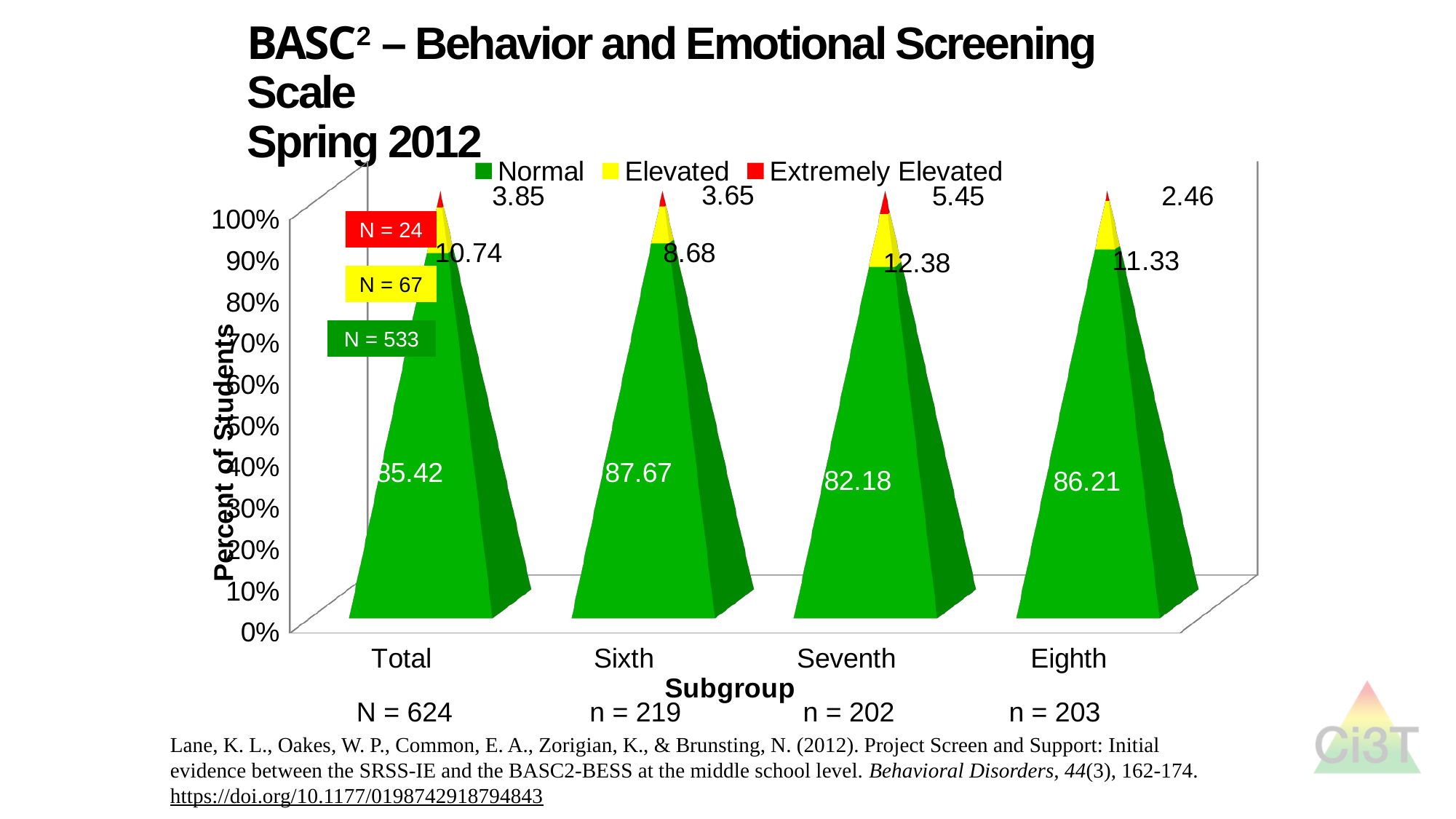
What is the Normal value for the Total subgroup? 85.42 Which subgroup has the highest Normal value? Sixth What kind of chart is shown? Stacked bar chart Which subgroup has the highest Extremely Elevated value? Seventh What is the Normal value for the Sixth subgroup? 87.67 Which is larger, the Elevated value for Sixth or for Eighth? Eighth How many subgroups are shown on the x axis? 4 What is the Elevated value for the Seventh subgroup? 12.38 What is the difference between the Normal values for Sixth and Seventh? 5.49 What is the Extremely Elevated value for the Eighth subgroup? 2.46 Which subgroup has the lowest Normal value? Seventh How many series does the legend list? 3